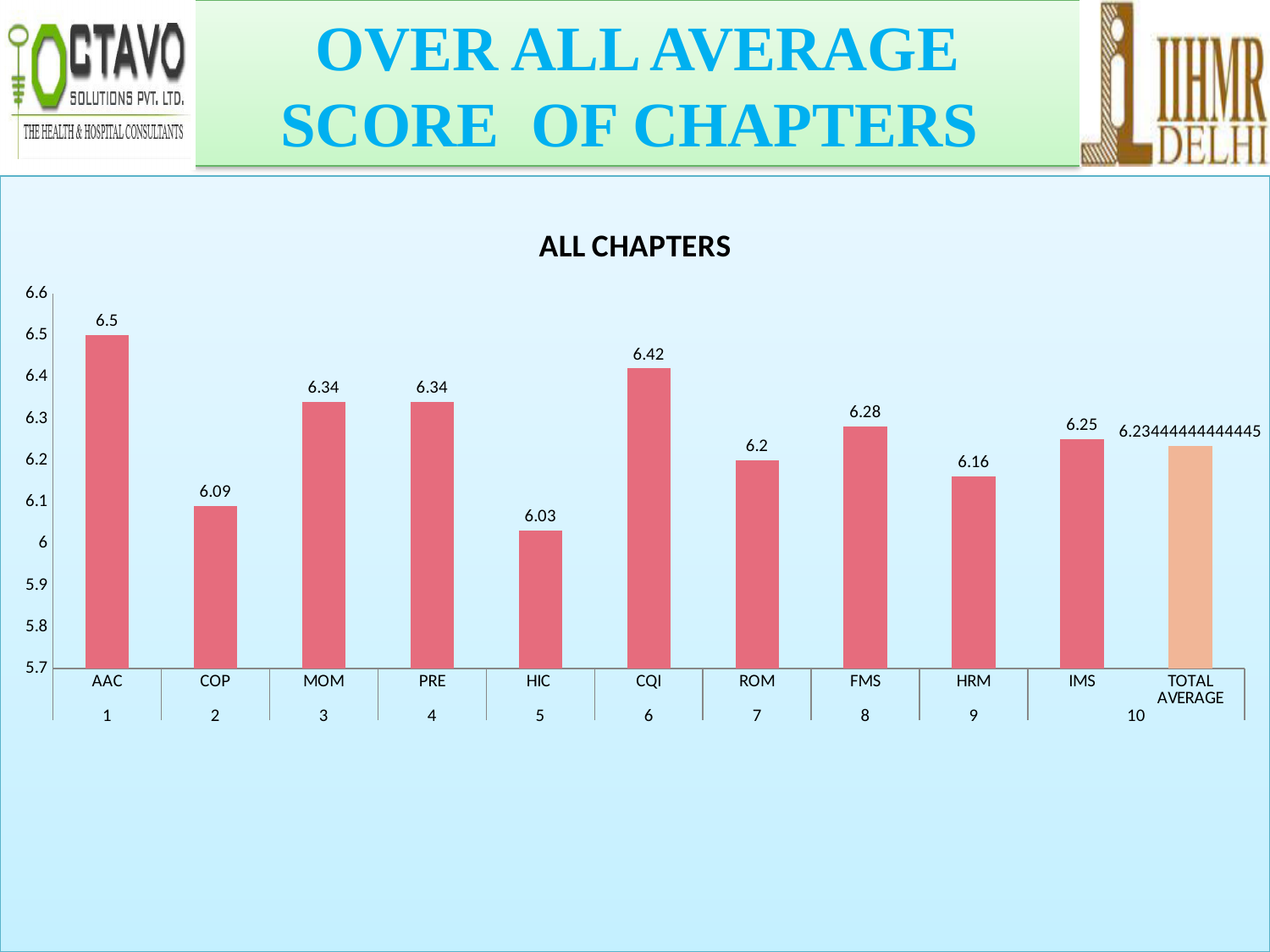
What is the value for HIC? 6.03 Which chapter has the highest score? AAC What is the difference between the values for AAC and HIC? 0.47 What is the value shown for TOTAL AVERAGE? 6.23444444444445 What is the title of the chart? ALL CHAPTERS What is the value for CQI? 6.42 How many bars are plotted in the chart? 11 Which chapter has the lowest score? HIC What is the value for AAC? 6.5 Which is larger, the value for COP or the value for ROM? ROM What is the difference between the values for FMS and HRM? 0.12 What kind of chart is shown? bar chart